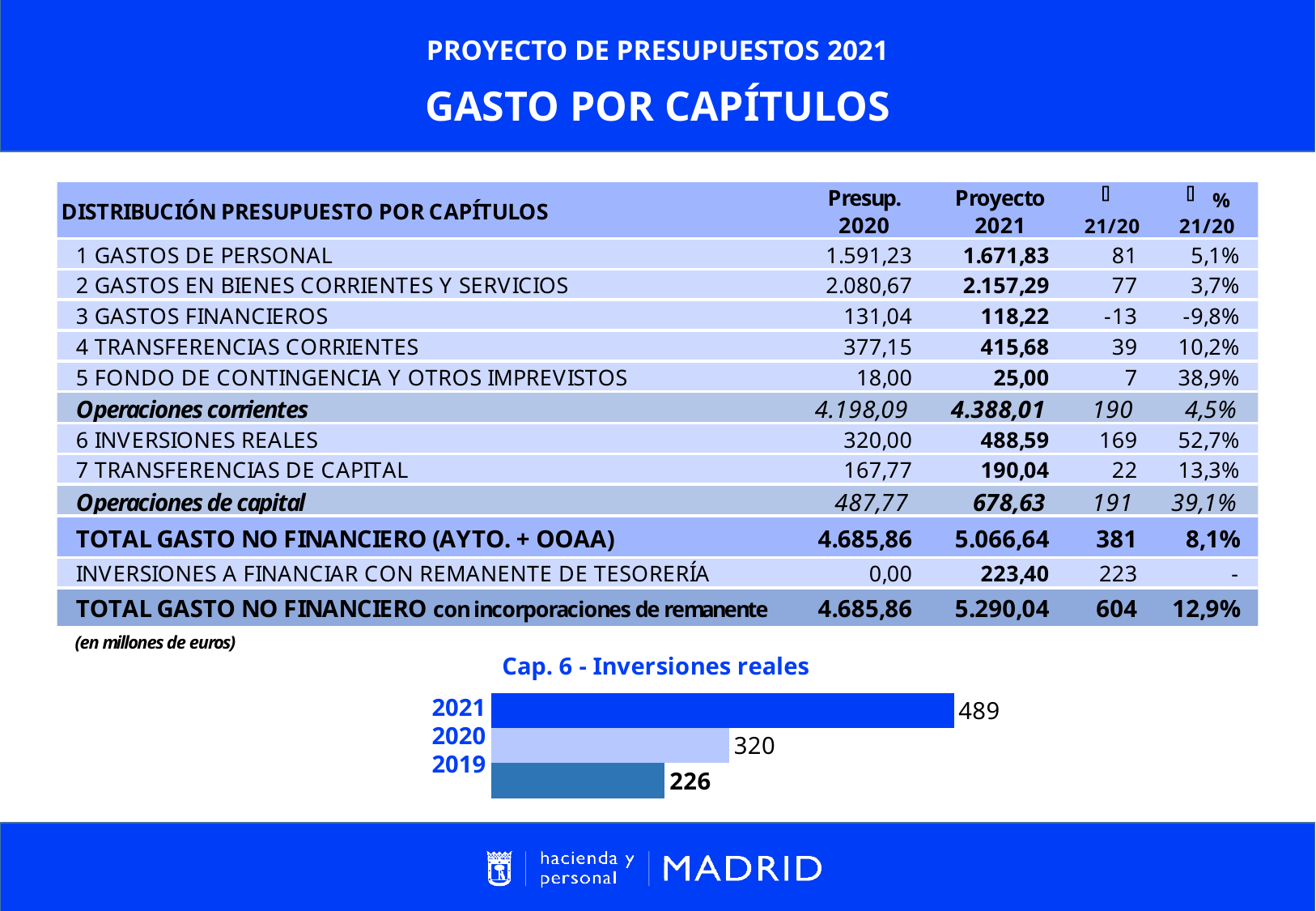
Do the values in the 'Cap. 6 - Inversiones reales' chart rise or fall from 2019 to 2021? rise What is the value for 2021 in the 'Cap. 6 - Inversiones reales' chart? 489 What is the value for 2019 in the 'Cap. 6 - Inversiones reales' chart? 226 In the 'Cap. 6 - Inversiones reales' chart, is the value for 2020 larger or smaller than the value for 2019? larger Which year has the highest value in the 'Cap. 6 - Inversiones reales' chart? 2021 What kind of chart is 'Cap. 6 - Inversiones reales'? bar chart What is the difference between the 2020 and 2019 values in the 'Cap. 6 - Inversiones reales' chart? 94 What is the difference between the 2021 and 2020 values in the 'Cap. 6 - Inversiones reales' chart? 169 What is the title of the chart on the slide? Cap. 6 - Inversiones reales Which year has the lowest value in the 'Cap. 6 - Inversiones reales' chart? 2019 What is the value for 2020 in the 'Cap. 6 - Inversiones reales' chart? 320 How many years are shown in the 'Cap. 6 - Inversiones reales' chart? 3